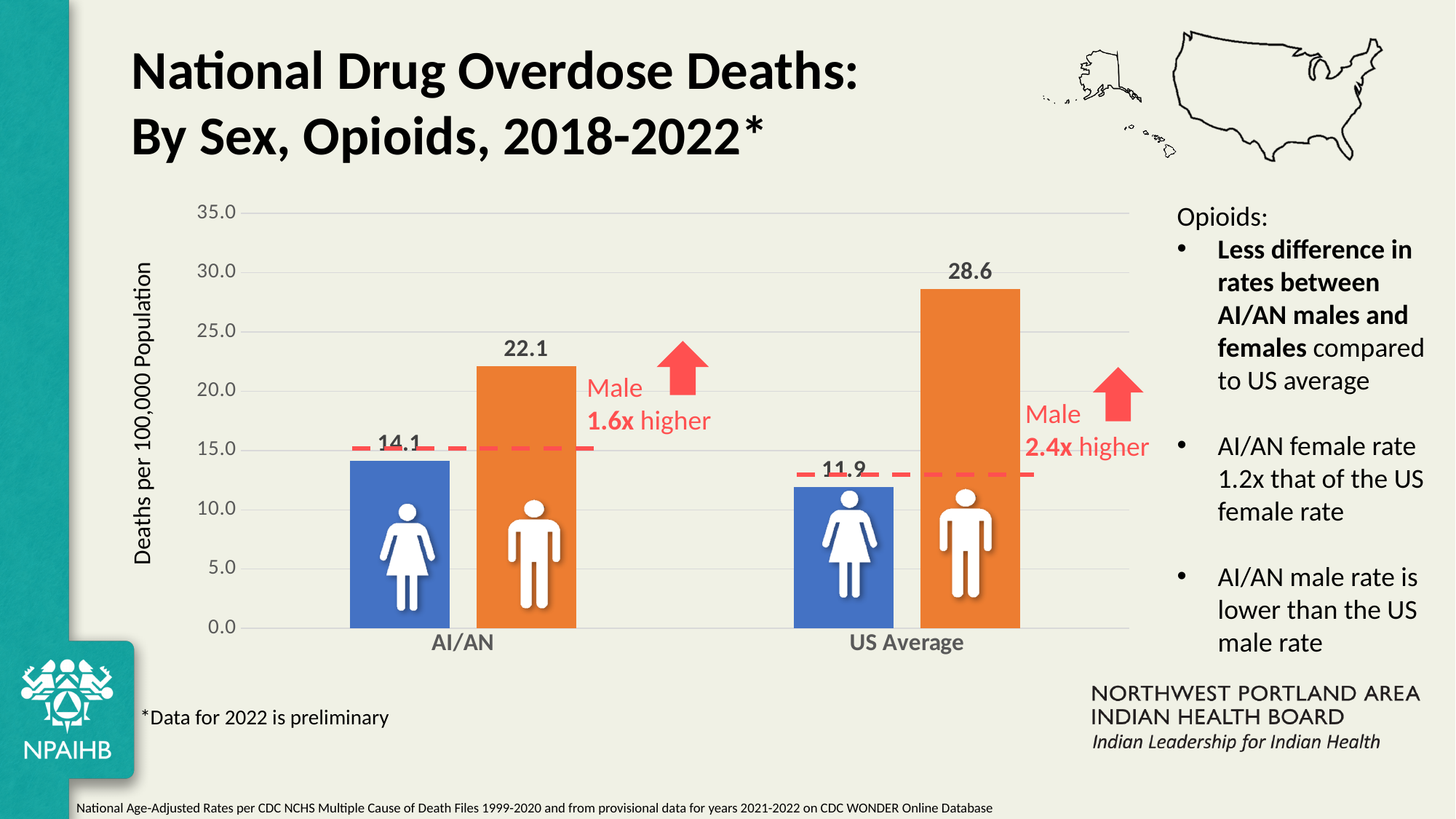
Which bar has the lowest value on the chart? US Average female (11.9) Which bar has the highest value on the chart? US Average male (28.6) Which is larger, the AI/AN female rate or the US Average female rate? AI/AN female rate What type of chart is shown on the slide? Bar chart How many category groups are shown on the x axis? 2 What is the opioid overdose death rate for AI/AN females? 14.1 What is the US Average opioid overdose death rate for males? 28.6 What is the label of the y axis? Deaths per 100,000 Population What is the opioid overdose death rate for AI/AN males? 22.1 What is the difference between the AI/AN male rate and the AI/AN female rate? 8.0 What is the difference between the US Average male rate and the AI/AN male rate? 6.5 What is the US Average opioid overdose death rate for females? 11.9